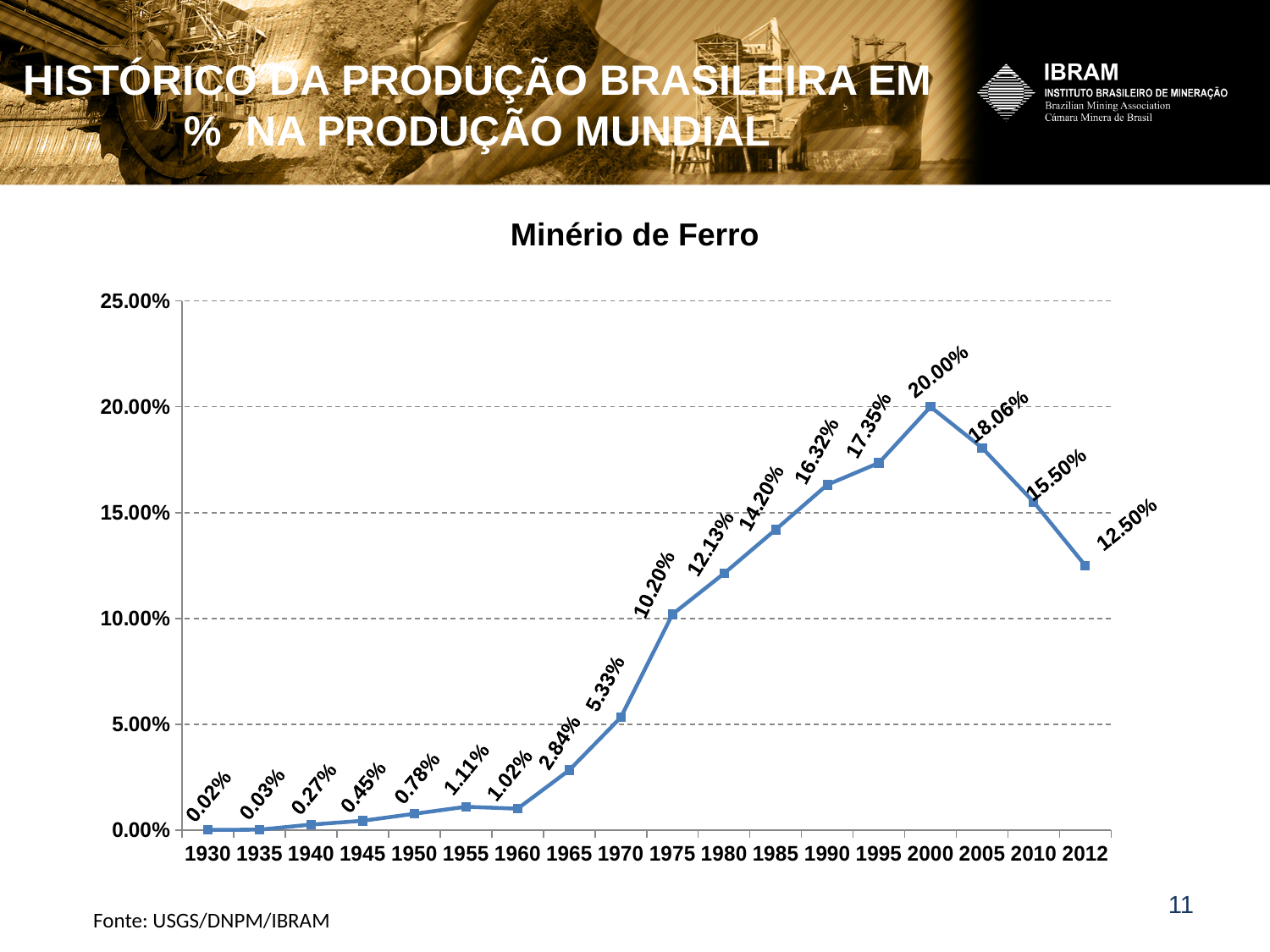
Do the values rise or fall between 2000 and 2012? fall Which year has the highest value? 2000 Which year has the lowest value? 1930 Is the value for 1990 greater or less than 15.00%? greater What type of chart is shown on the slide? line chart How many data points are plotted on the chart? 18 What is the value for 2000? 20.00% What is the title of the chart? Minério de Ferro What is the value for 2012? 12.50% What is the value for 1975? 10.20% Which is larger, the value for 1955 or the value for 1960? 1955 What is the difference between the values for 2000 and 2012? 7.50%